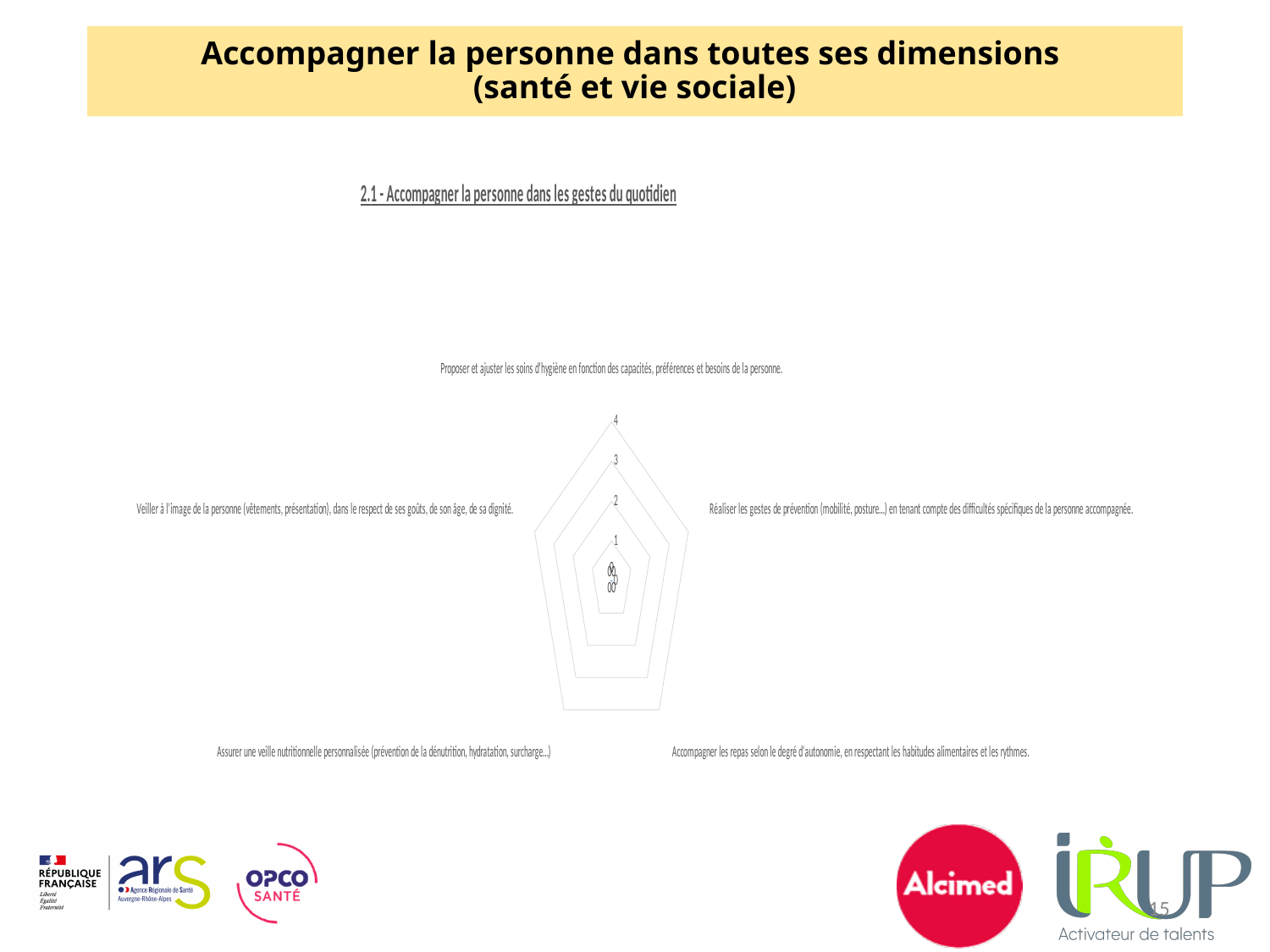
How many categories (axes) does the radar chart have? 5 Which category label appears at the top of the radar chart? Proposer et ajuster les soins d'hygiène en fonction des capacités, préférences et besoins de la personne. What is the title of the radar chart? 2.1 - Accompagner la personne dans les gestes du quotidien What kind of chart is shown on the slide? Radar chart What is the highest value shown on the radar chart's scale? 4